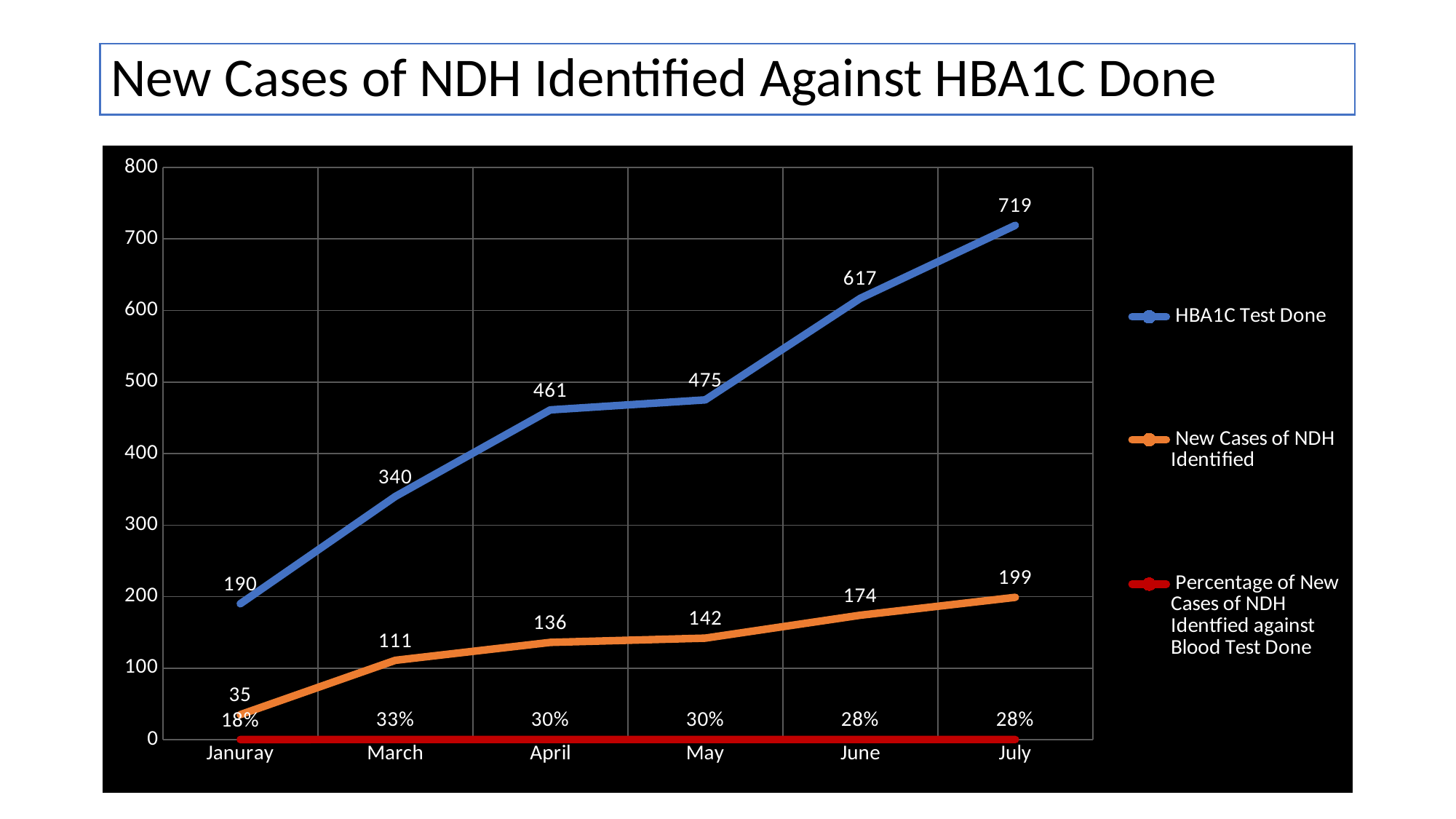
How many series does the legend list? 3 What is the value of HBA1C Test Done in April? 461 How many New Cases of NDH Identified were there in June? 174 In which month is New Cases of NDH Identified lowest? Januray Does HBA1C Test Done rise or fall from Januray to July? rise What is the Percentage of New Cases of NDH Identified against Blood Test Done in March? 33% In which month is HBA1C Test Done highest? July Is the value for HBA1C Test Done in March greater or less than 300? greater What kind of chart is shown on the slide? line chart Which is larger: New Cases of NDH Identified in May or in April? May How many months are shown on the x axis? 6 What is the difference between HBA1C Test Done in July and in June? 102